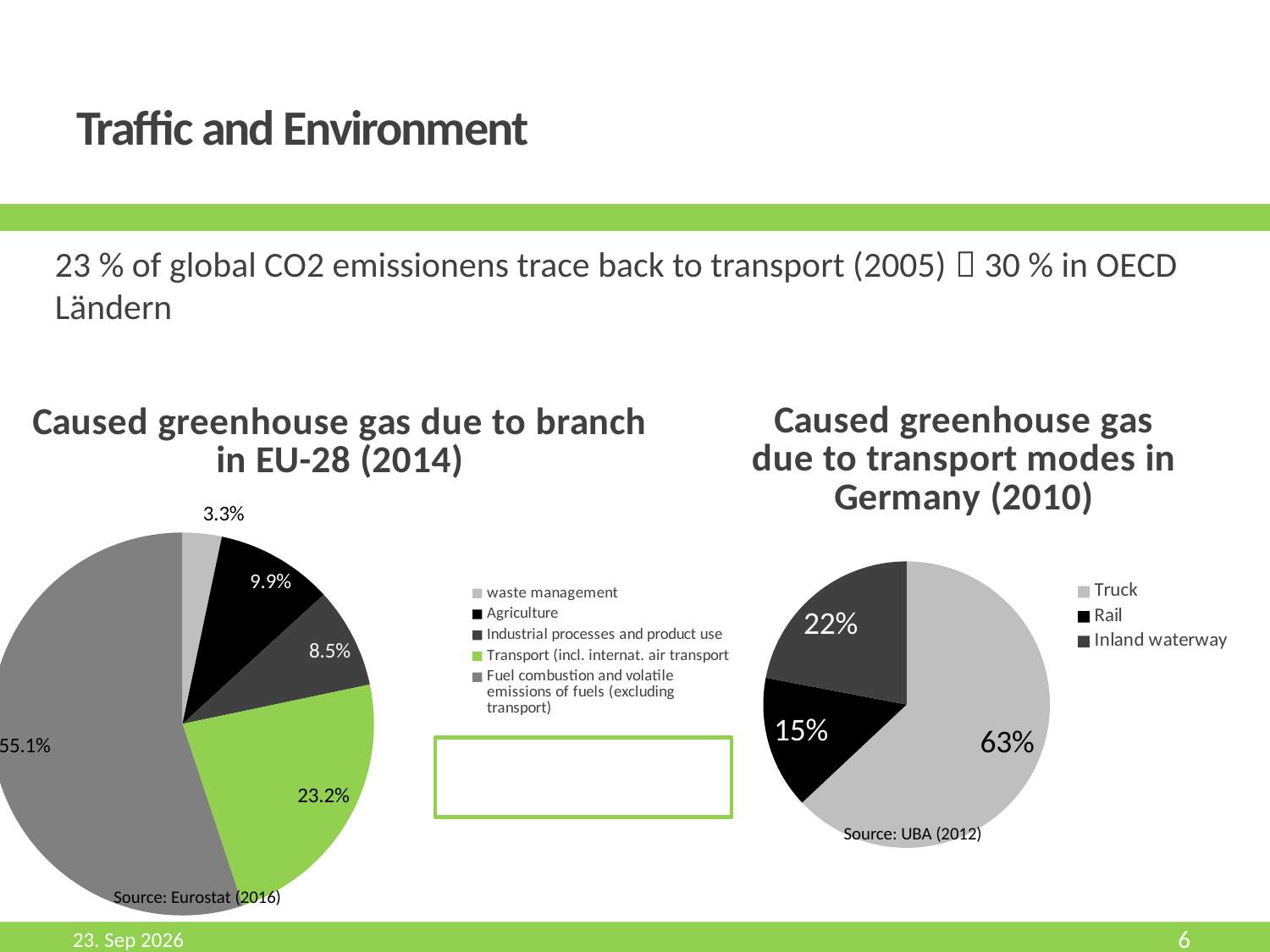
In the chart 'Caused greenhouse gas due to transport modes in Germany (2010)', what share is attributed to Rail? 15% In the chart 'Caused greenhouse gas due to transport modes in Germany (2010)', what share is attributed to Truck? 63% In the chart 'Caused greenhouse gas due to branch in EU-28 (2014)', which branch has the smallest share? waste management In the chart 'Caused greenhouse gas due to transport modes in Germany (2010)', what is the difference between the Truck share and the Inland waterway share? 41% How many categories does the legend of the chart 'Caused greenhouse gas due to branch in EU-28 (2014)' list? 5 In the chart 'Caused greenhouse gas due to transport modes in Germany (2010)', which transport mode has the smallest share? Rail In the chart 'Caused greenhouse gas due to branch in EU-28 (2014)', what share is attributed to Transport (incl. internat. air transport)? 23.2% In the chart 'Caused greenhouse gas due to branch in EU-28 (2014)', which branch has the largest share? Fuel combustion and volatile emissions of fuels (excluding transport) In the chart 'Caused greenhouse gas due to branch in EU-28 (2014)', what share is attributed to Agriculture? 9.9% In the chart 'Caused greenhouse gas due to branch in EU-28 (2014)', which is larger: the share for Agriculture or the share for Industrial processes and product use? Agriculture In the chart 'Caused greenhouse gas due to transport modes in Germany (2010)', what share is attributed to Inland waterway? 22% In the chart 'Caused greenhouse gas due to transport modes in Germany (2010)', which transport mode has the largest share? Truck